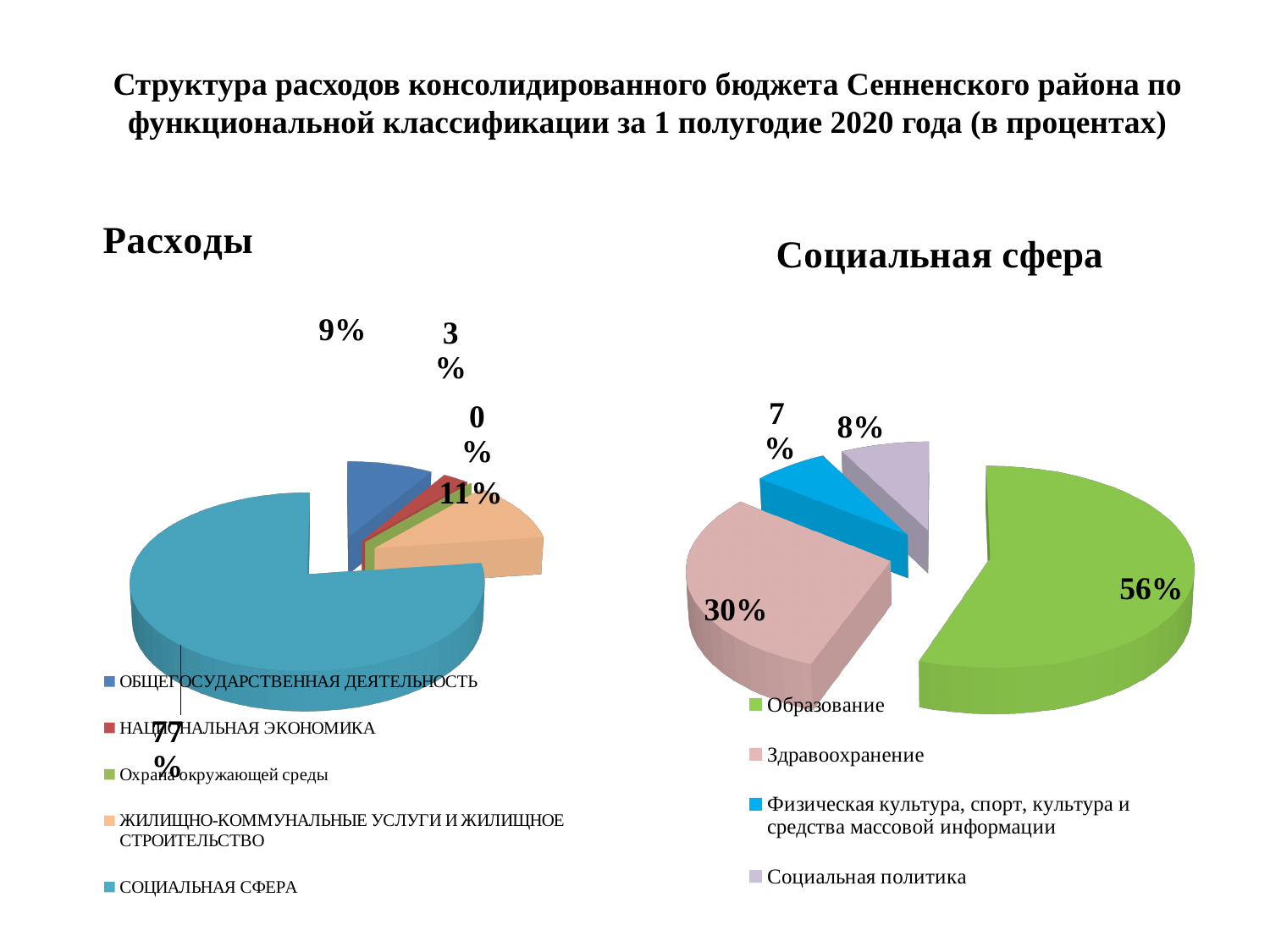
In the "Социальная сфера" chart, which is larger: Социальная политика or Физическая культура, спорт, культура и средства массовой информации? Социальная политика In the "Социальная сфера" chart, what is the difference between the shares of Образование and Здравоохранение? 26% In the "Расходы" chart, which category has the smallest share? Охрана окружающей среды In the "Социальная сфера" chart, what share does Здравоохранение have? 30% In the "Расходы" chart, what share does СОЦИАЛЬНАЯ СФЕРА have? 77% In the "Расходы" chart, which category has the largest share? СОЦИАЛЬНАЯ СФЕРА What kind of chart is the "Социальная сфера" chart? Pie chart In the "Расходы" chart, what share does ЖИЛИЩНО-КОММУНАЛЬНЫЕ УСЛУГИ И ЖИЛИЩНОЕ СТРОИТЕЛЬСТВО have? 11% In the "Социальная сфера" chart, what share does Социальная политика have? 8% How many categories does the legend of the "Расходы" chart list? 5 In the "Социальная сфера" chart, which category has the largest share? Образование In the "Расходы" chart, what is the difference between the shares of ОБЩЕГОСУДАРСТВЕННАЯ ДЕЯТЕЛЬНОСТЬ and НАЦИОНАЛЬНАЯ ЭКОНОМИКА? 6%